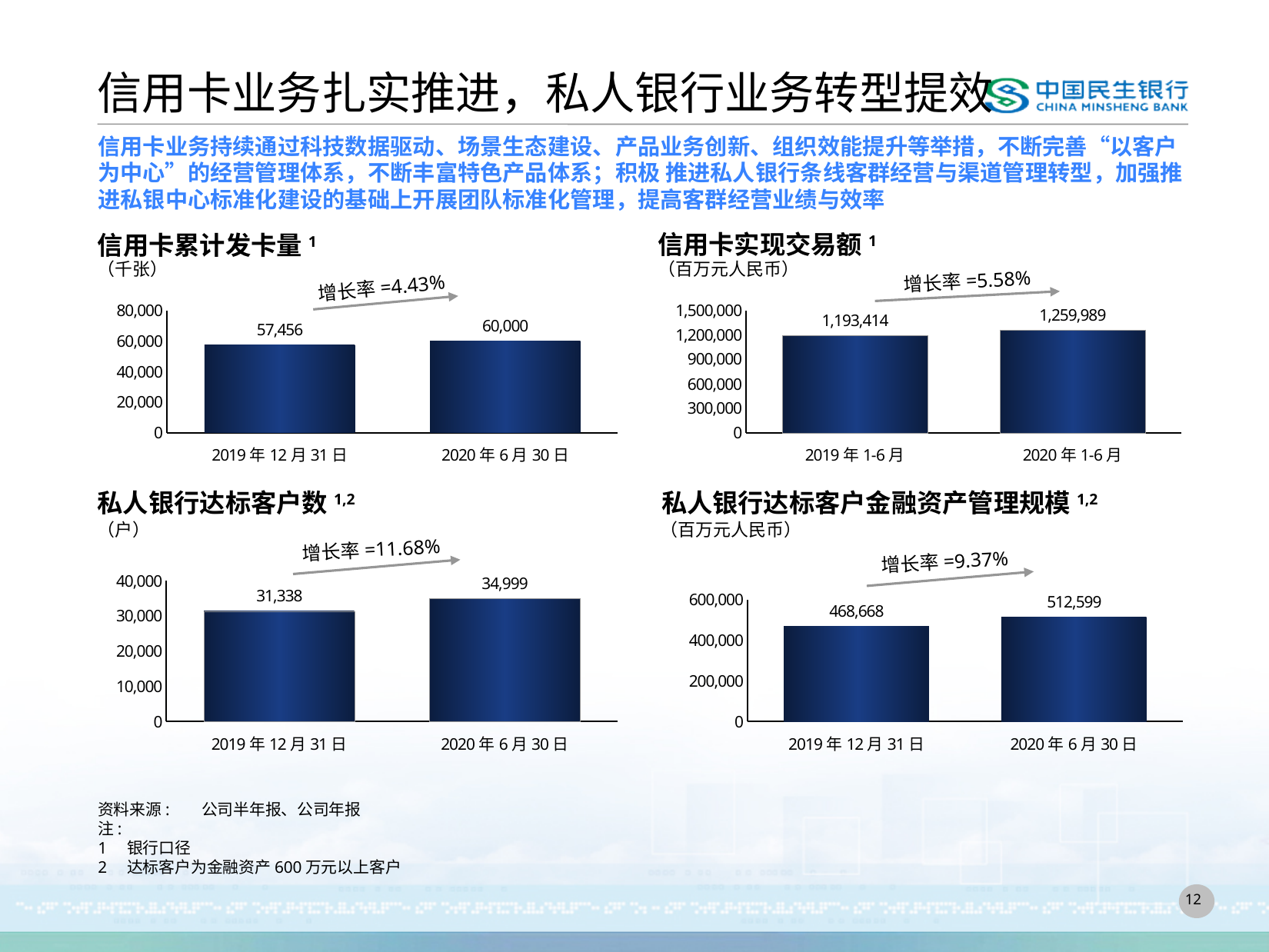
In the bottom-left chart (私人银行达标客户数), which period has the higher value? 2020年6月30日 In the bottom-right chart (私人银行达标客户金融资产管理规模), what is the value for 2020年6月30日? 512,599 In the bottom-left chart (私人银行达标客户数), what is the value for 2019年12月31日? 31,338 What growth rate (增长率) is annotated on the bottom-left chart (私人银行达标客户数)? 11.68% In the top-right chart (信用卡实现交易额), what is the value for 2020年1-6月? 1,259,989 In the bottom-right chart (私人银行达标客户金融资产管理规模), is the value for 2019年12月31日 greater or less than 400,000? greater In the top-left chart (信用卡累计发卡量), what is the value for 2020年6月30日? 60,000 In the top-right chart (信用卡实现交易额), what is the difference between the 2020年1-6月 and 2019年1-6月 values? 66,575 In the bottom-left chart (私人银行达标客户数), what is the difference between the 2020年6月30日 and 2019年12月31日 values? 3,661 In the top-left chart (信用卡累计发卡量), what is the value for 2019年12月31日? 57,456 How many bars are shown in the top-left chart (信用卡累计发卡量)? 2 What type of chart is the top-right chart (信用卡实现交易额)? bar chart